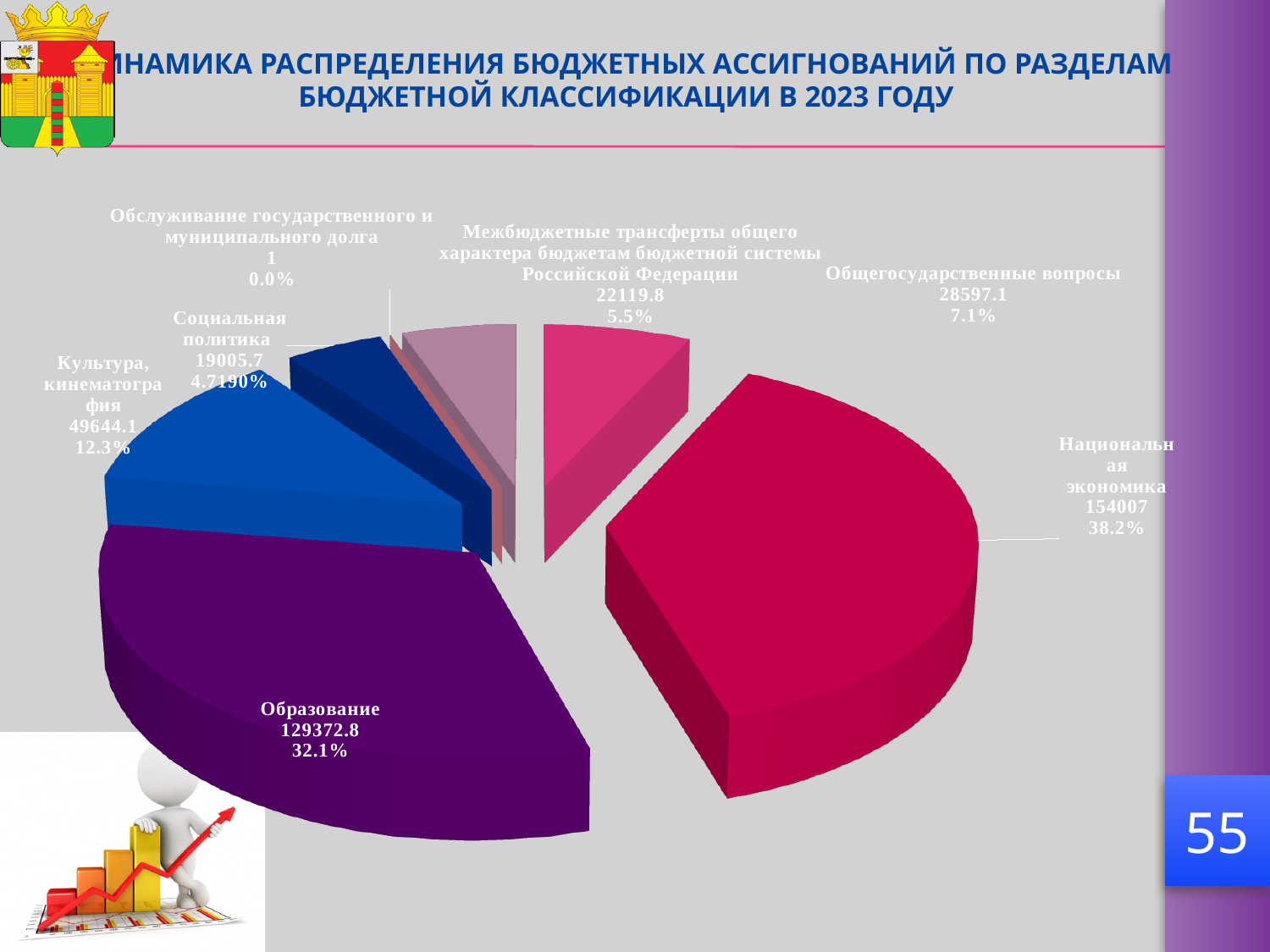
What share of the pie does Образование represent? 32.1% What is the value shown for Национальная экономика? 154007 What is the difference between the values for Национальная экономика and Образование? 24634.2 What is the value shown for Образование? 129372.8 Which section has the largest slice of the pie? Национальная экономика What share of the pie does Общегосударственные вопросы represent? 7.1% What share of the pie does Национальная экономика represent? 38.2% Which section has the smallest slice of the pie? Обслуживание государственного и муниципального долга What kind of chart is shown on the slide? Pie chart Which is larger, the value for Образование or the value for Культура, кинематография? Образование What is the value shown for Культура, кинематография? 49644.1 What is the value shown for Межбюджетные трансферты общего характера бюджетам бюджетной системы Российской Федерации? 22119.8